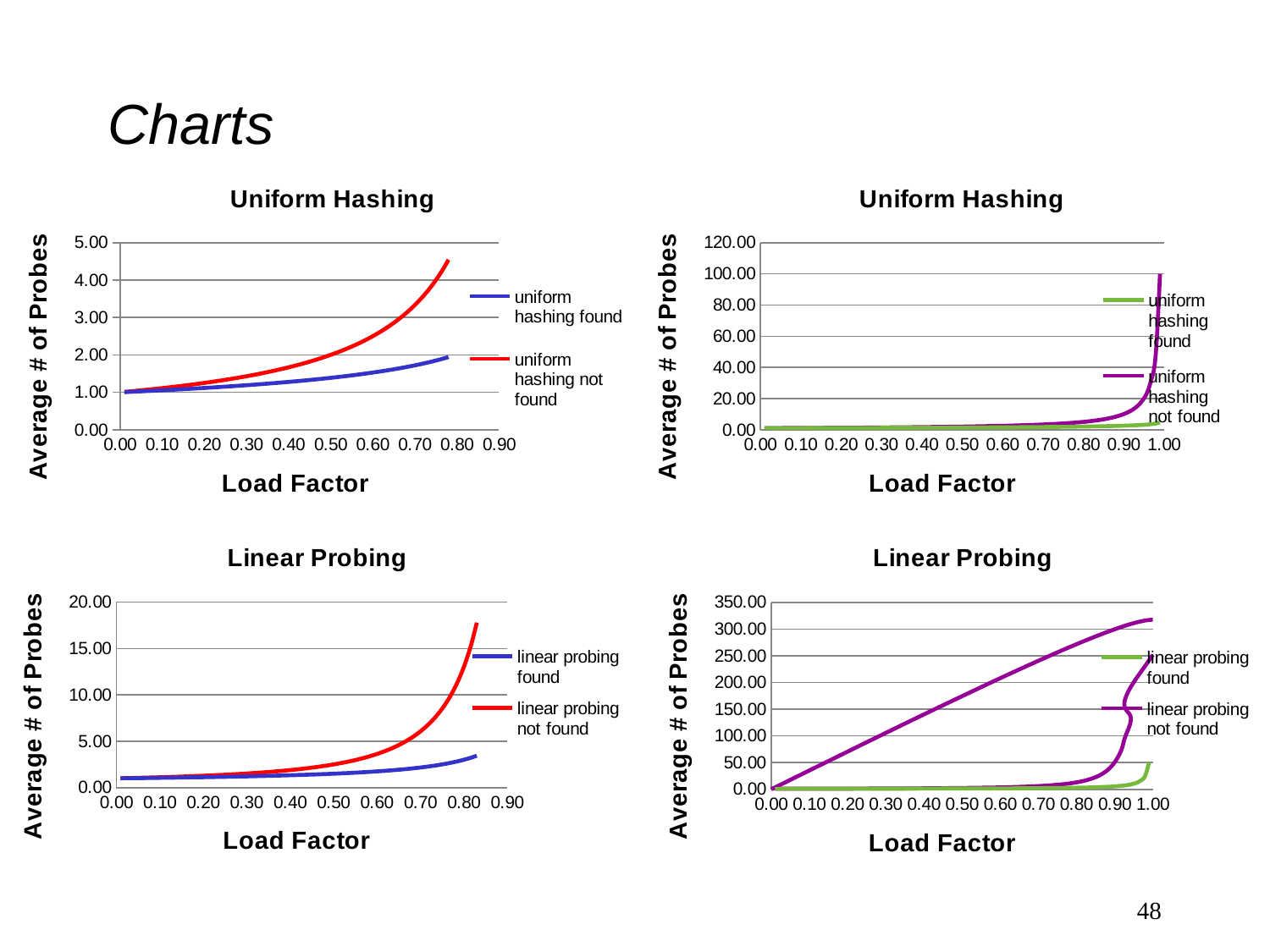
In the bottom-left Linear Probing chart, at a load factor of 0.80, is the value for 'linear probing found' greater or less than 5.00? less In the top-left Uniform Hashing chart, at a load factor of 0.70, is the value for 'uniform hashing not found' greater or less than 3.00? greater In the bottom-left Linear Probing chart, which series is higher at a load factor of 0.80, 'linear probing found' or 'linear probing not found'? linear probing not found In the top-left Uniform Hashing chart, does the 'uniform hashing not found' line rise or fall as the load factor increases? rise In the top-right Uniform Hashing chart, at a load factor of 0.90, is the value for 'uniform hashing not found' greater or less than 20.00? less What is the x-axis label of the top-right Uniform Hashing chart? Load Factor In the top-left Uniform Hashing chart, which series is higher at a load factor of 0.70, 'uniform hashing found' or 'uniform hashing not found'? uniform hashing not found What is the y-axis label of the bottom-left Linear Probing chart? Average # of Probes How many series does the legend of the top-left Uniform Hashing chart list? 2 What type of chart is the top-left Uniform Hashing chart? line chart